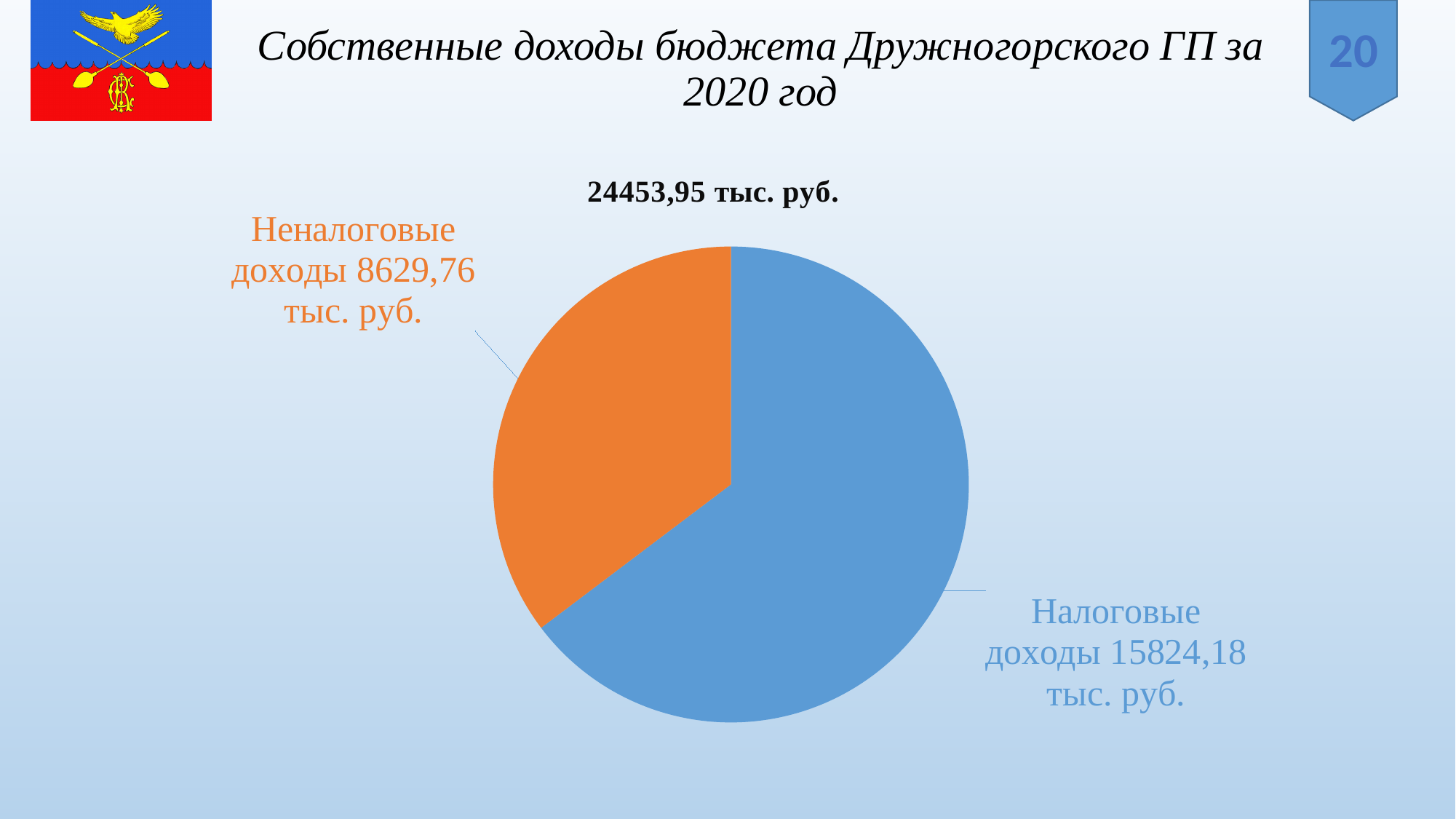
What is the difference between Налоговые доходы and Неналоговые доходы? 7194,42 тыс. руб. What total value is shown above the pie chart? 24453,95 тыс. руб. How many slices does the pie chart have? 2 Which category has the smallest slice in the pie chart? Неналоговые доходы Which is larger, Налоговые доходы or Неналоговые доходы? Налоговые доходы Which category has the largest slice in the pie chart? Налоговые доходы What is the value of Налоговые доходы in the pie chart? 15824,18 тыс. руб. What colour is the slice for Неналоговые доходы? orange What is the value of Неналоговые доходы in the pie chart? 8629,76 тыс. руб. What colour is the slice for Налоговые доходы? blue What type of chart is shown on the slide? pie chart